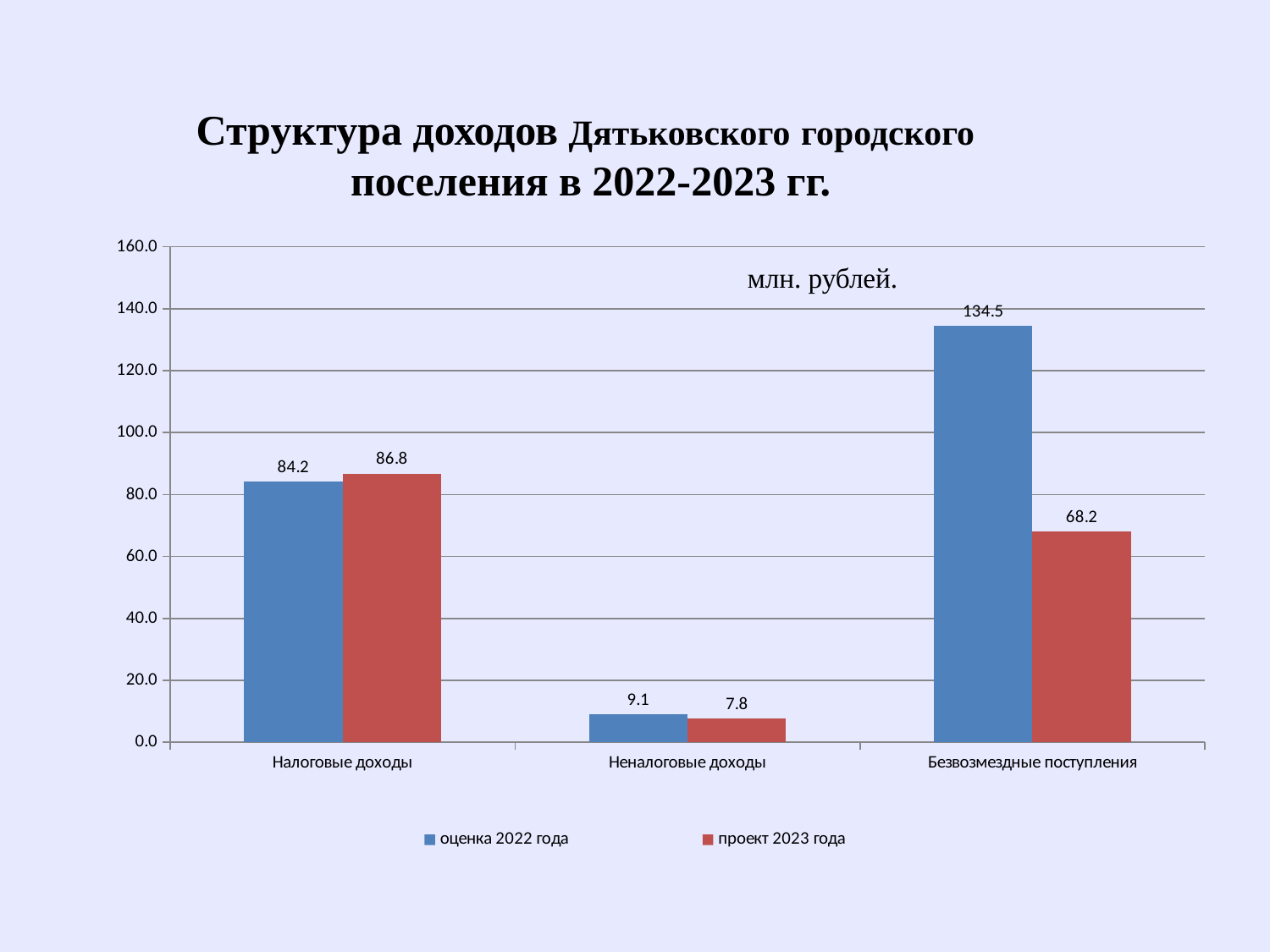
Which category has the lowest value in the проект 2023 года series? Неналоговые доходы What kind of chart is shown on the slide? bar chart What is the value for Неналоговые доходы in the оценка 2022 года series? 9.1 What is the value for Налоговые доходы in the оценка 2022 года series? 84.2 Which category has the highest value in the оценка 2022 года series? Безвозмездные поступления What is the value for Безвозмездные поступления in the проект 2023 года series? 68.2 What unit is indicated on the chart? млн. рублей. Is the оценка 2022 года value for Безвозмездные поступления greater or less than 120.0? greater How many series does the legend list? 2 What is the difference between the оценка 2022 года and проект 2023 года values for Безвозмездные поступления? 66.3 How many categories are shown on the x axis? 3 Which is larger for Налоговые доходы: the оценка 2022 года value or the проект 2023 года value? проект 2023 года